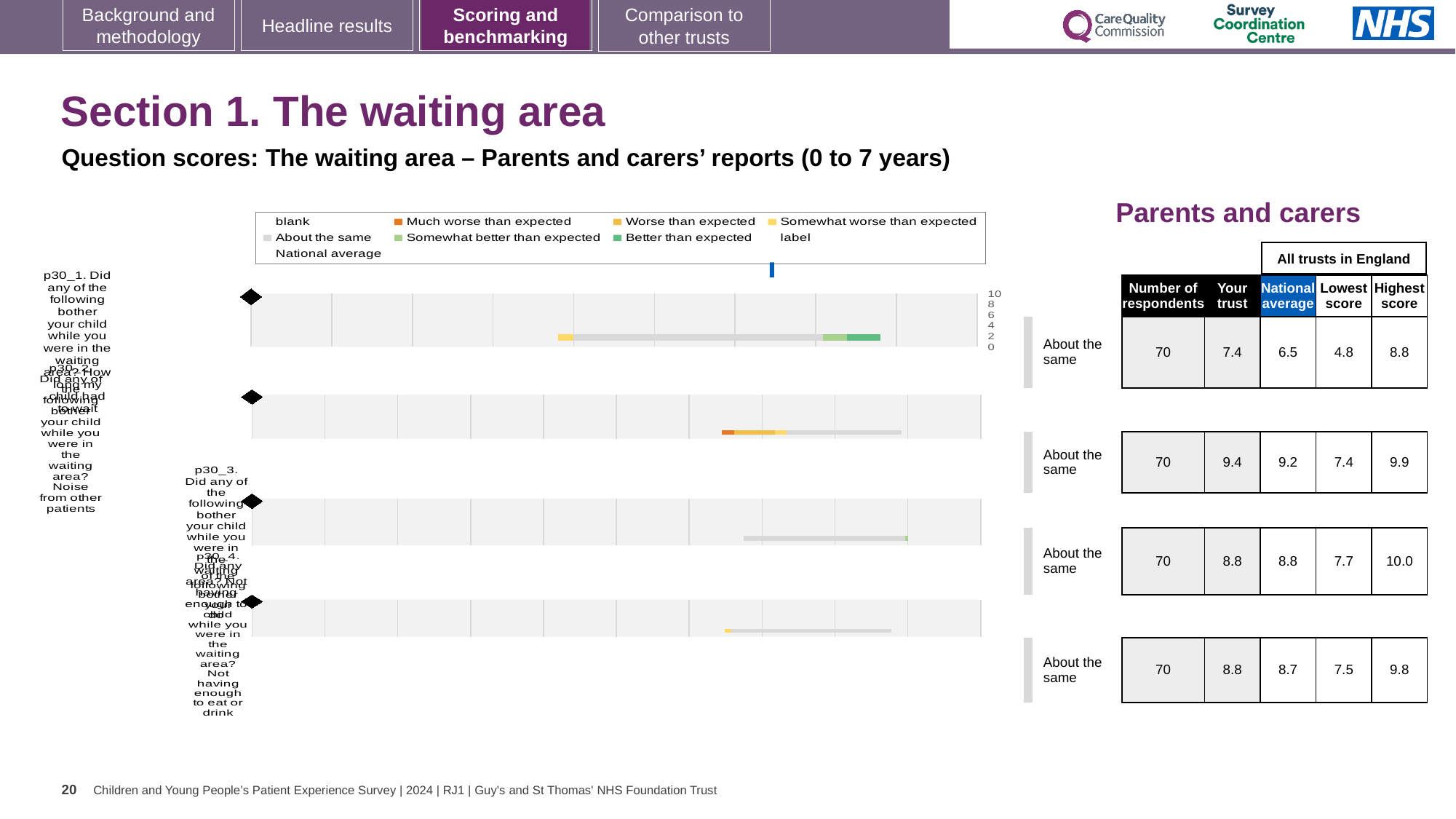
In the table beside the chart, what is the 'Your trust' score for the first row (p30_1, waiting area: how long my child had to wait)? 7.4 In the table beside the chart, what is the national average for the second row (p30_2, noise from other patients)? 9.2 What colour does the legend use for 'Much worse than expected'? orange In the table beside the chart, what is the highest score for the third row (p30_3, not having enough to do)? 10.0 How many question bars are plotted in the chart? 4 In the table beside the chart, what is the lowest score for the fourth row (p30_4, not having enough to eat or drink)? 7.5 Which row has the higher 'Your trust' score: the first row (p30_1) or the second row (p30_2)? p30_2 What colour does the legend use for 'Better than expected'? green What is the highest tick value shown on the chart's axis? 10 What is the difference between the 'Your trust' score and the national average in the first row (p30_1)? 0.9 How many respondents are listed for each question in the table beside the chart? 70 What kind of chart is shown on the slide? bar chart